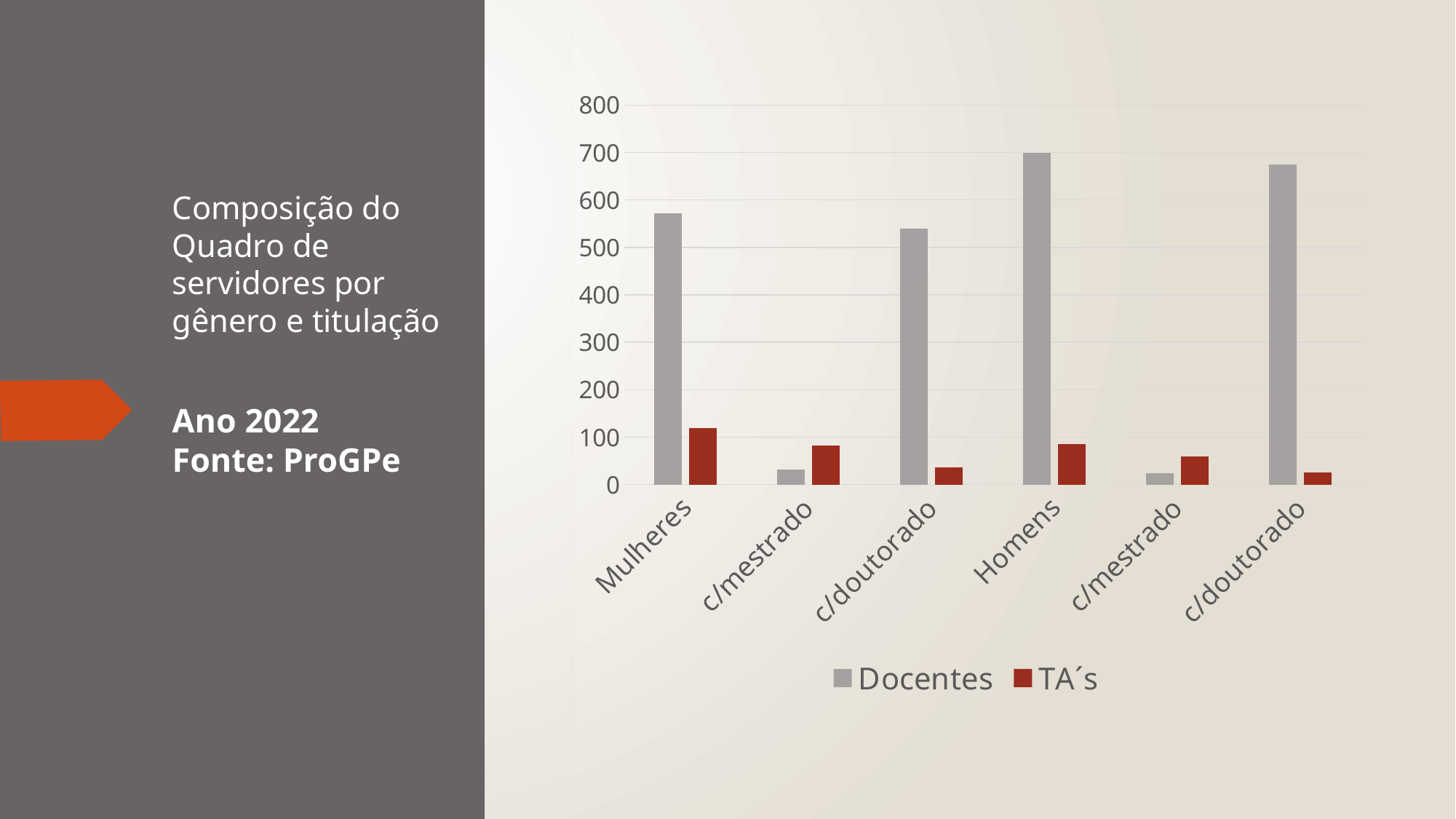
Which is larger, the Docentes value for Mulheres or the Docentes value for Homens? Homens Is the TA´s value for Homens greater or less than 100? less Which category has the highest TA´s value? Mulheres Which is larger, the TA´s value for Mulheres or the TA´s value for Homens? Mulheres What kind of chart is shown on the slide? bar chart Is the Docentes value for the first c/mestrado category (left of centre) greater or less than 100? less Is the Docentes value for Mulheres greater or less than 500? greater Which category has the highest Docentes value? Homens What colour are the bars for the TA´s series? dark red How many categories are shown along the x axis? 6 How many series does the legend list? 2 What are the two series named in the legend? Docentes and TA´s